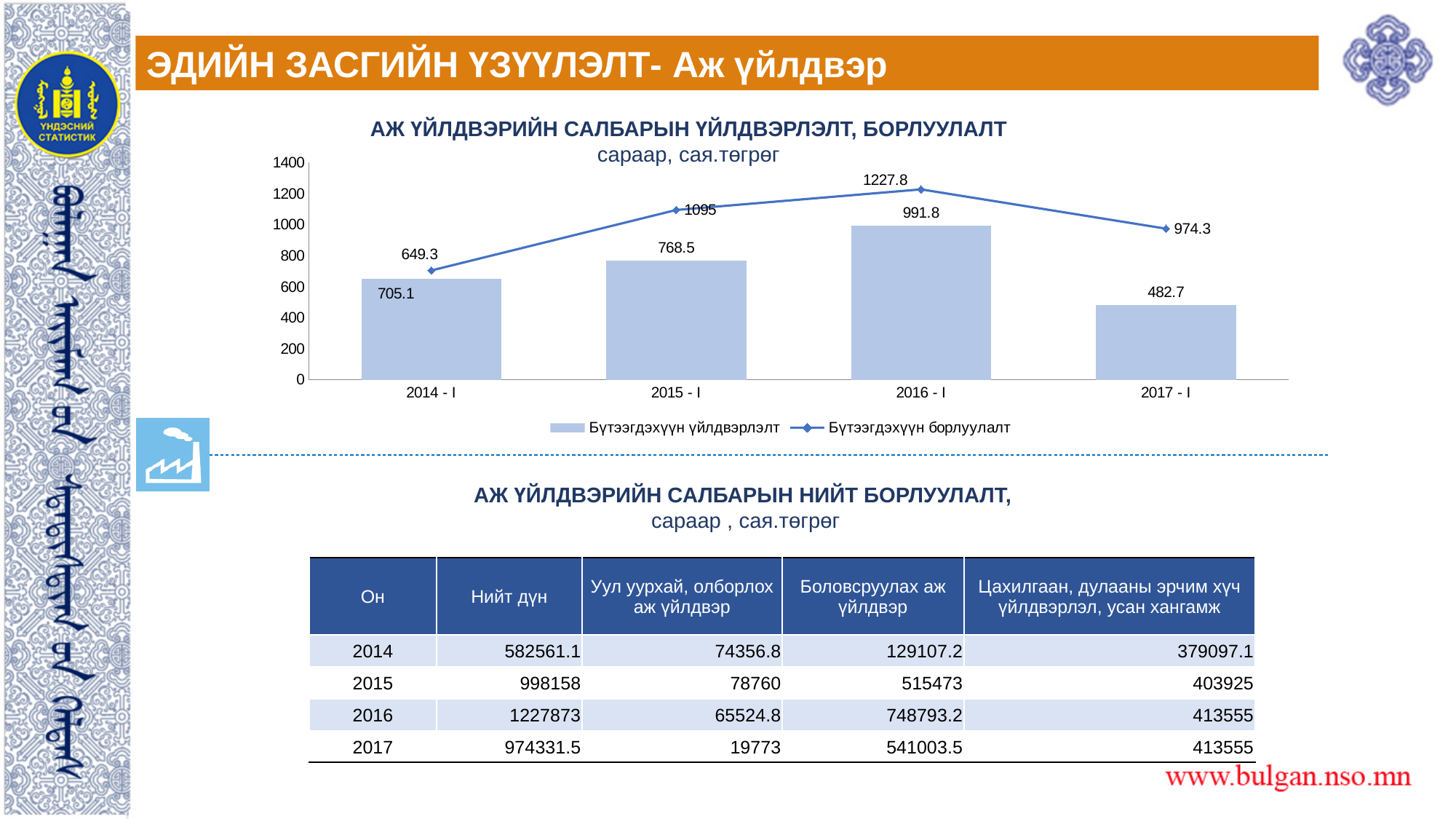
What is the difference between Бүтээгдэхүүн борлуулалт and Бүтээгдэхүүн үйлдвэрлэлт for 2016 - I? 236 Does Бүтээгдэхүүн үйлдвэрлэлт rise or fall from 2016 - I to 2017 - I? fall Which period has the highest value for Бүтээгдэхүүн борлуулалт? 2016 - I What is the value of Бүтээгдэхүүн борлуулалт for 2015 - I? 1095 How many series does the chart legend list? 2 What is the value of Бүтээгдэхүүн үйлдвэрлэлт for 2016 - I? 991.8 How many periods are shown on the x axis of the chart? 4 What is the value of Бүтээгдэхүүн борлуулалт for 2014 - I? 705.1 Is the value of Бүтээгдэхүүн борлуулалт for 2017 - I greater or less than 800? greater What is the value of Бүтээгдэхүүн үйлдвэрлэлт for 2017 - I? 482.7 Which period has the lowest value for Бүтээгдэхүүн үйлдвэрлэлт? 2017 - I Which is larger for 2014 - I: Бүтээгдэхүүн үйлдвэрлэлт or Бүтээгдэхүүн борлуулалт? Бүтээгдэхүүн борлуулалт